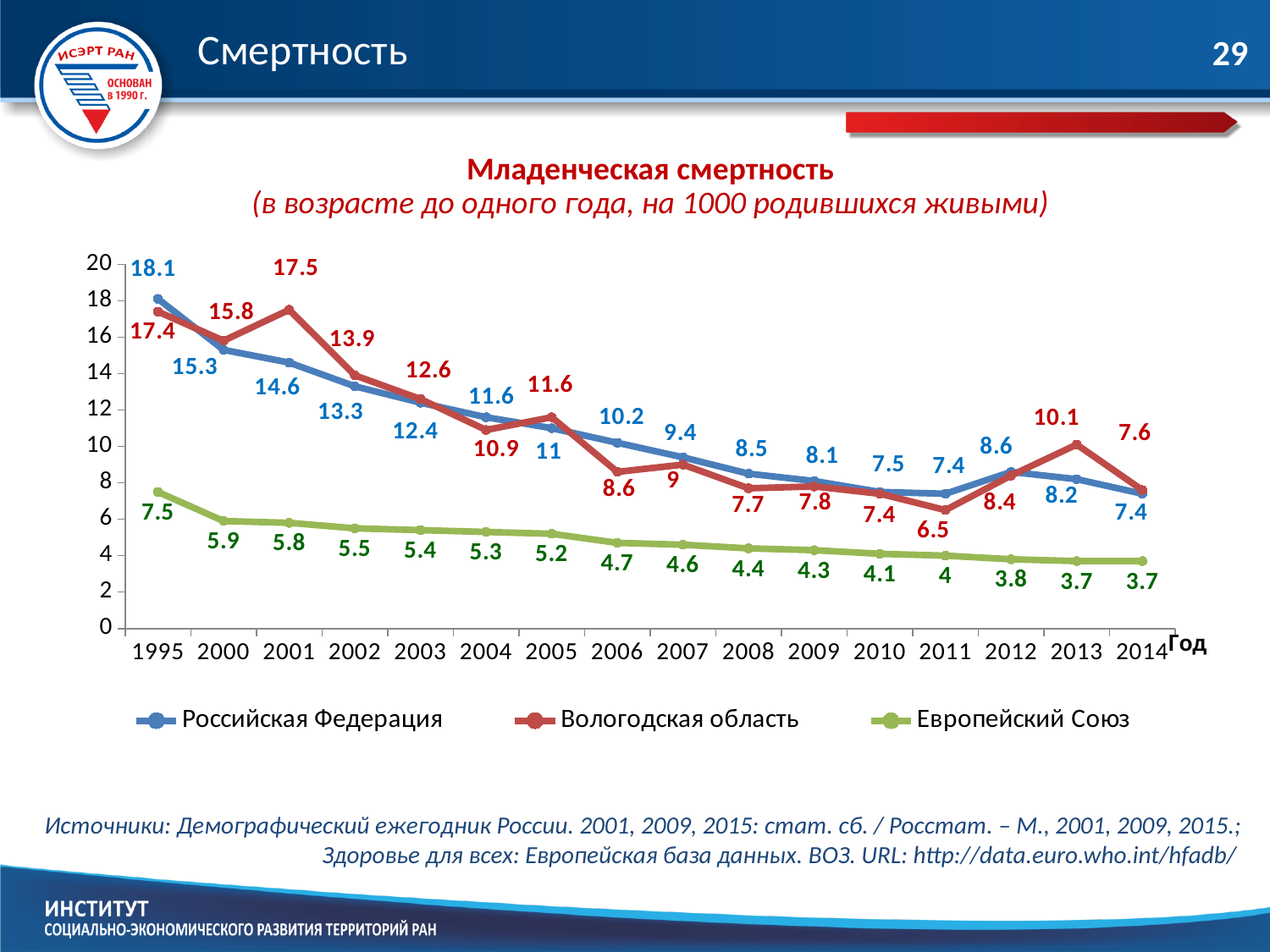
Does the Европейский Союз series generally rise or fall from 1995 to 2014? fall In which year does the Вологодская область series reach its highest value? 2001 What is the difference between the Российская Федерация value and the Европейский Союз value in 2014? 3.7 How many series does the legend list? 3 In which year does the Вологодская область series reach its lowest value? 2011 What is the value for Российская Федерация in 1995? 18.1 What is the value for Европейский Союз in 2014? 3.7 What is the value for Вологодская область in 2013? 10.1 What is the title of the chart? Младенческая смертность (в возрасте до одного года, на 1000 родившихся живыми) How many years are plotted along the x axis? 16 Which is larger in 2001: the value for Российская Федерация or for Вологодская область? Вологодская область What type of chart is shown on the slide? line chart